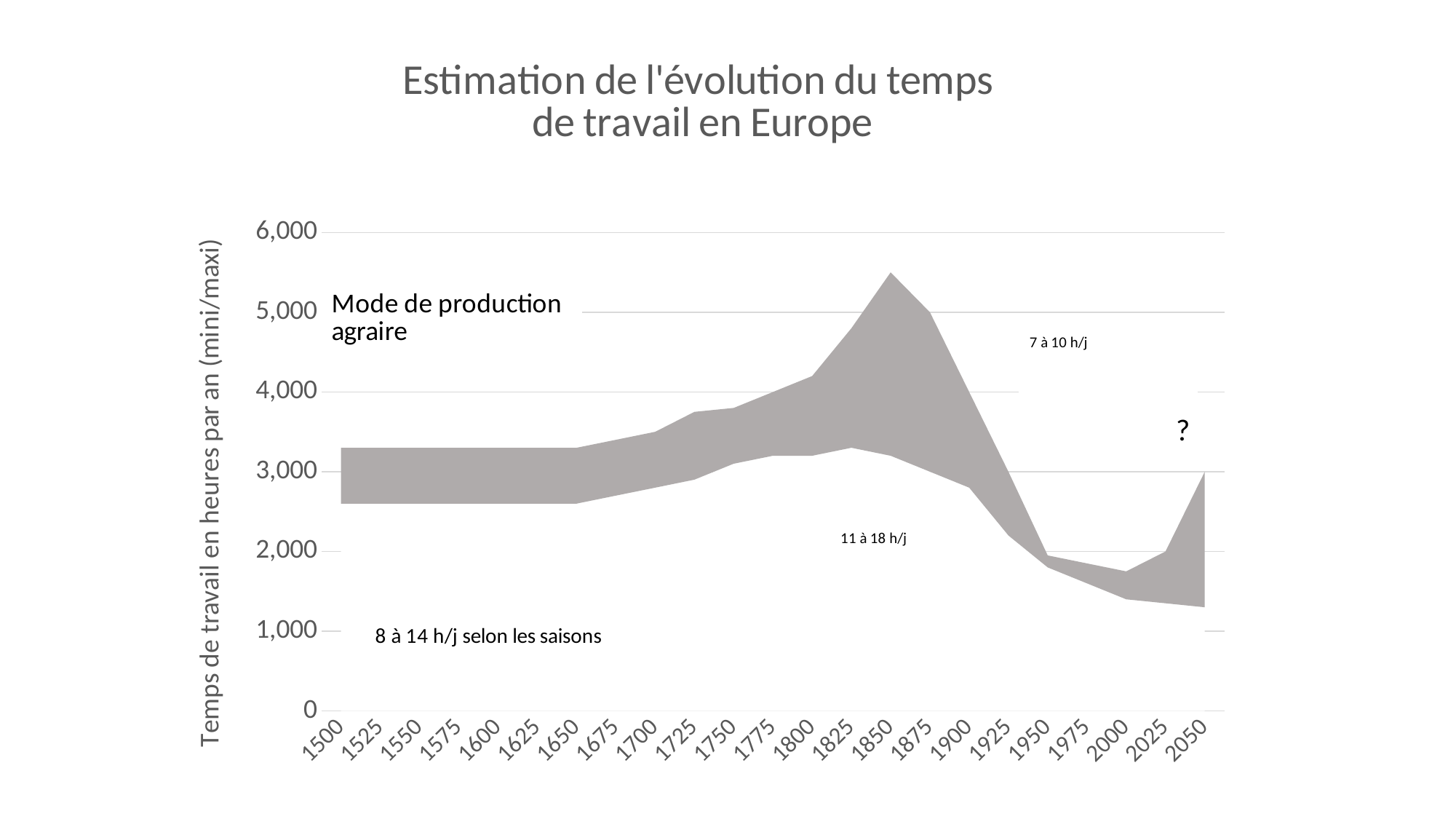
Is the upper estimate for 1950 greater or less than 3,000? less What is the title of the chart? Estimation de l'évolution du temps de travail en Europe Is the lower estimate for 1500 greater or less than 2,000? greater Between 1850 and 2000, does the estimated working time rise or fall? fall Is the upper estimate for 1500 greater or less than 3,000? greater How many year labels are shown along the x axis? 23 What kind of chart is shown on the slide? Area chart In which year does the upper estimate of working time reach its highest point? 1850 In which year is the upper estimate of working time at its lowest? 2000 What is the label of the vertical axis? Temps de travail en heures par an (mini/maxi)